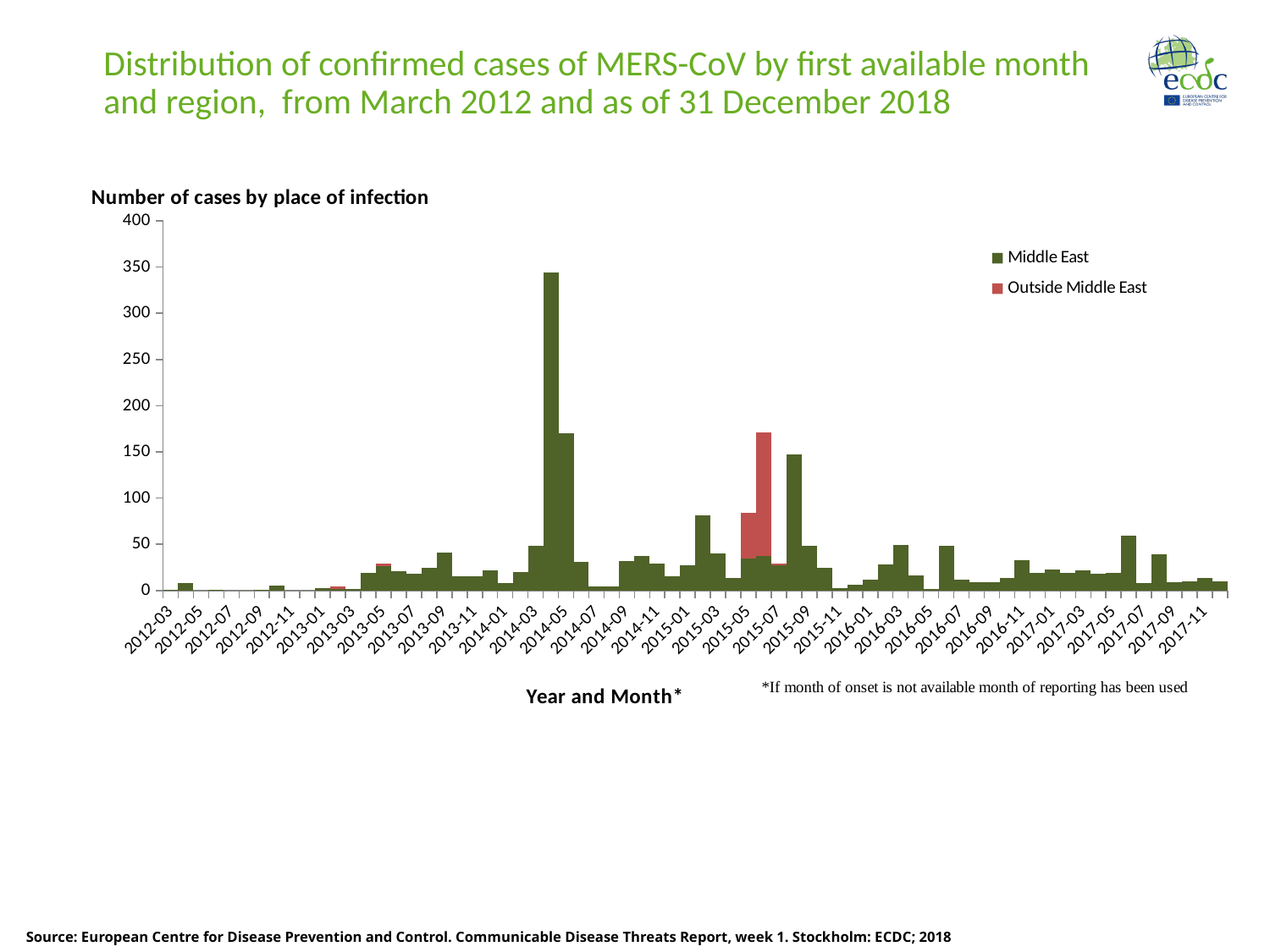
Is the number of cases for 2017-11 greater or less than 50? less Is the total number of cases for 2015-05 greater or less than 50? greater Is the total number of cases for 2016-03 greater or less than 100? less What is the title of the x axis? Year and Month* What are the two series named in the legend? Middle East and Outside Middle East How many series does the legend list? 2 Which series reaches the highest single-month value on the chart, Middle East or Outside Middle East? Middle East What kind of chart is shown on the slide? Bar chart